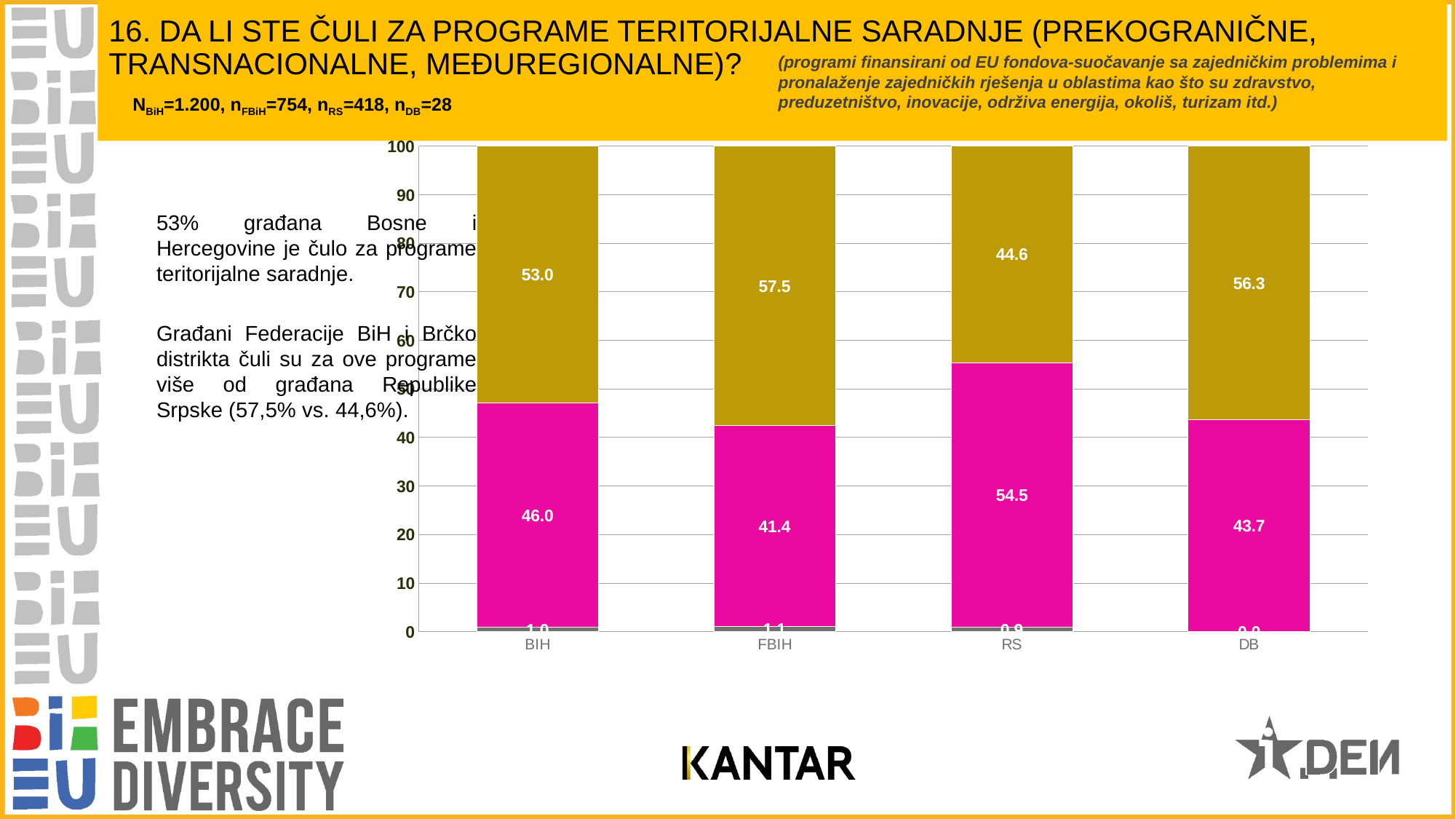
Which category has the highest value in the gold (top) segment? FBIH What is the difference between the gold segment values for FBIH and RS? 12.9 Is the magenta segment value for RS greater or less than 50? greater What is the value of the magenta segment for RS? 54.5 Which category has the lowest value in the gold (top) segment? RS What is the value of the gold (top) segment for FBIH? 57.5 How many categories are shown on the x axis of the chart? 4 What is the value of the gold (top) segment for BIH? 53.0 Which has the larger magenta segment value, BIH or DB? BIH What is the maximum value shown on the y axis of the chart? 100 What is the value of the magenta segment for DB? 43.7 What kind of chart is shown on the slide? Stacked bar chart